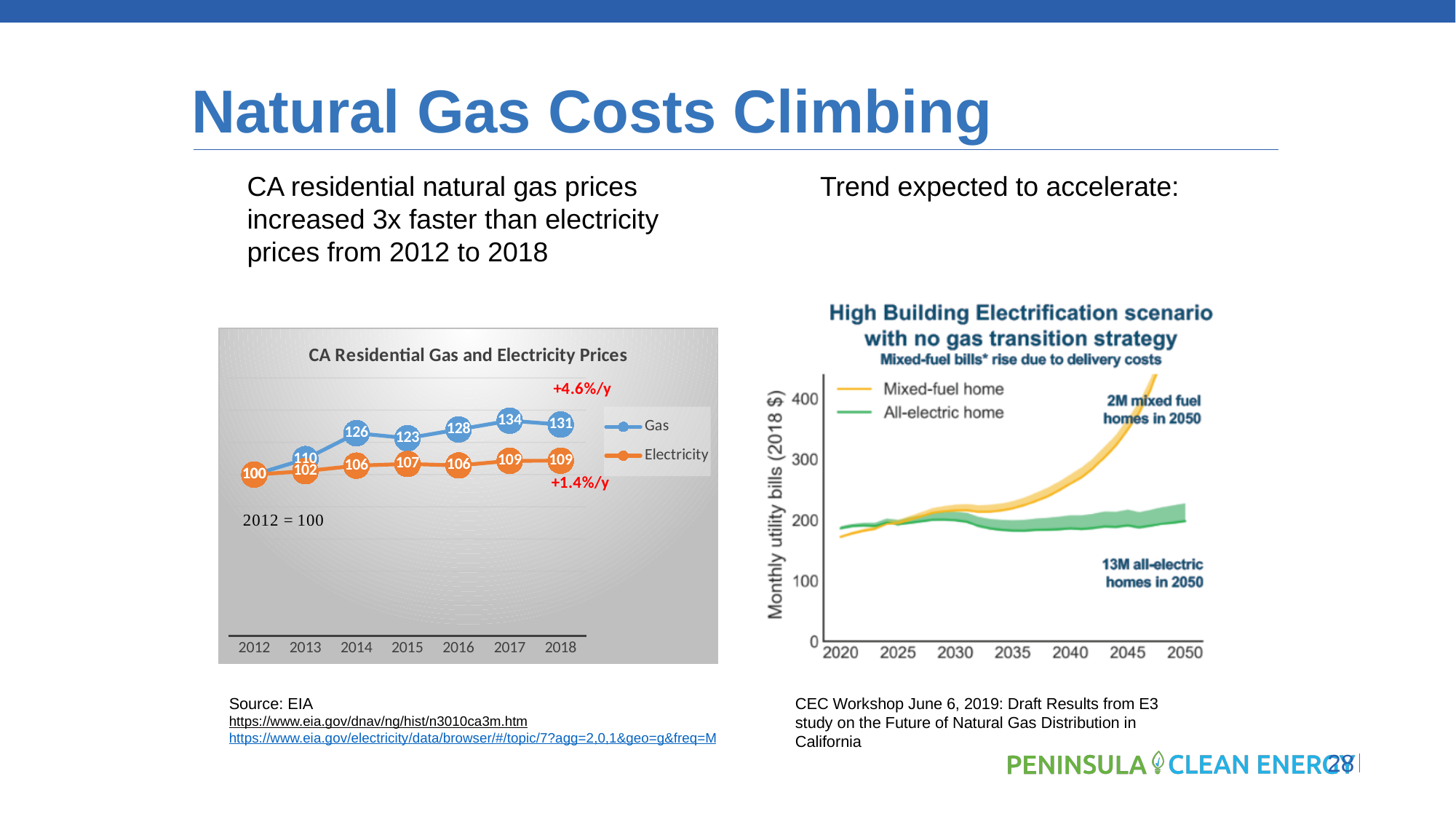
How many series does the legend of the High Building Electrification scenario chart list? 2 How many series does the legend of the CA Residential Gas and Electricity Prices chart list? 2 In the CA Residential Gas and Electricity Prices chart, which year has the highest Gas value? 2017 In the High Building Electrification scenario chart, is the Mixed-fuel home value in 2045 greater or less than 300? greater In the CA Residential Gas and Electricity Prices chart, what is the Electricity value for 2015? 107 In the CA Residential Gas and Electricity Prices chart, what is the Gas value for 2017? 134 In the CA Residential Gas and Electricity Prices chart, what is the difference between the Gas and Electricity values in 2018? 22 How many years are shown on the x axis of the CA Residential Gas and Electricity Prices chart? 7 In the CA Residential Gas and Electricity Prices chart, which is larger in 2014, the Gas value or the Electricity value? Gas In the High Building Electrification scenario chart, does the Mixed-fuel home line rise or fall from 2030 to 2050? rise In the CA Residential Gas and Electricity Prices chart, what annual growth rate is annotated for the Gas series? +4.6%/y What type of chart is the CA Residential Gas and Electricity Prices chart? line chart